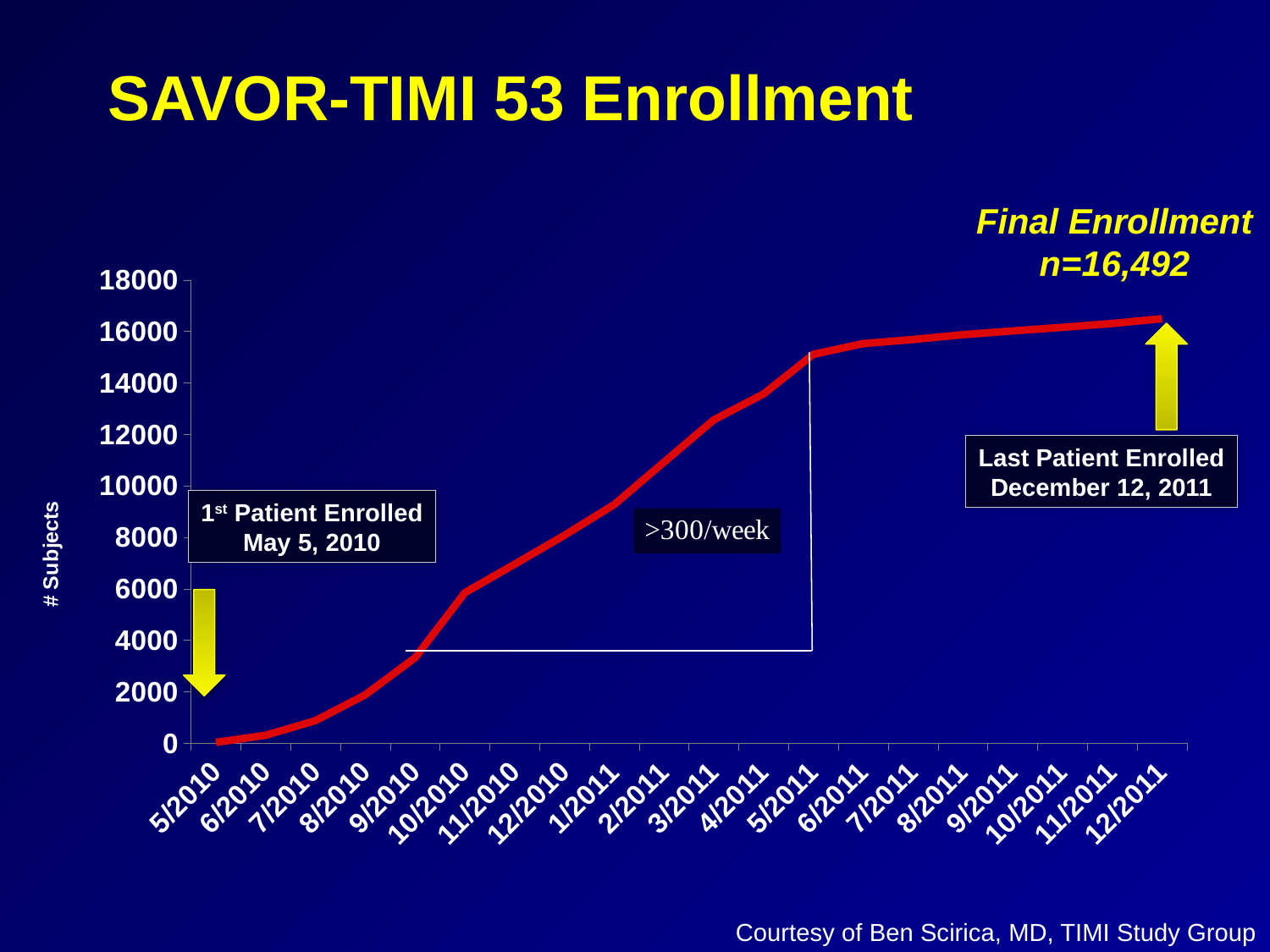
Which month has the lowest number of subjects on the chart? 5/2010 What is the final enrollment figure shown on the slide? n=16,492 Is the number of subjects at 7/2010 greater or less than 2000? less Is the number of subjects at 9/2010 greater or less than 4000? less How many months are labelled along the x axis of the chart? 20 Do the values on the chart rise or fall from 5/2010 to 12/2011? rise What kind of chart is shown on the slide? line chart Which month has more subjects, 2/2011 or 4/2011? 4/2011 Is the number of subjects at 12/2011 greater or less than 16000? greater What is the label on the y axis of the chart? # Subjects Which month has the highest number of subjects on the chart? 12/2011